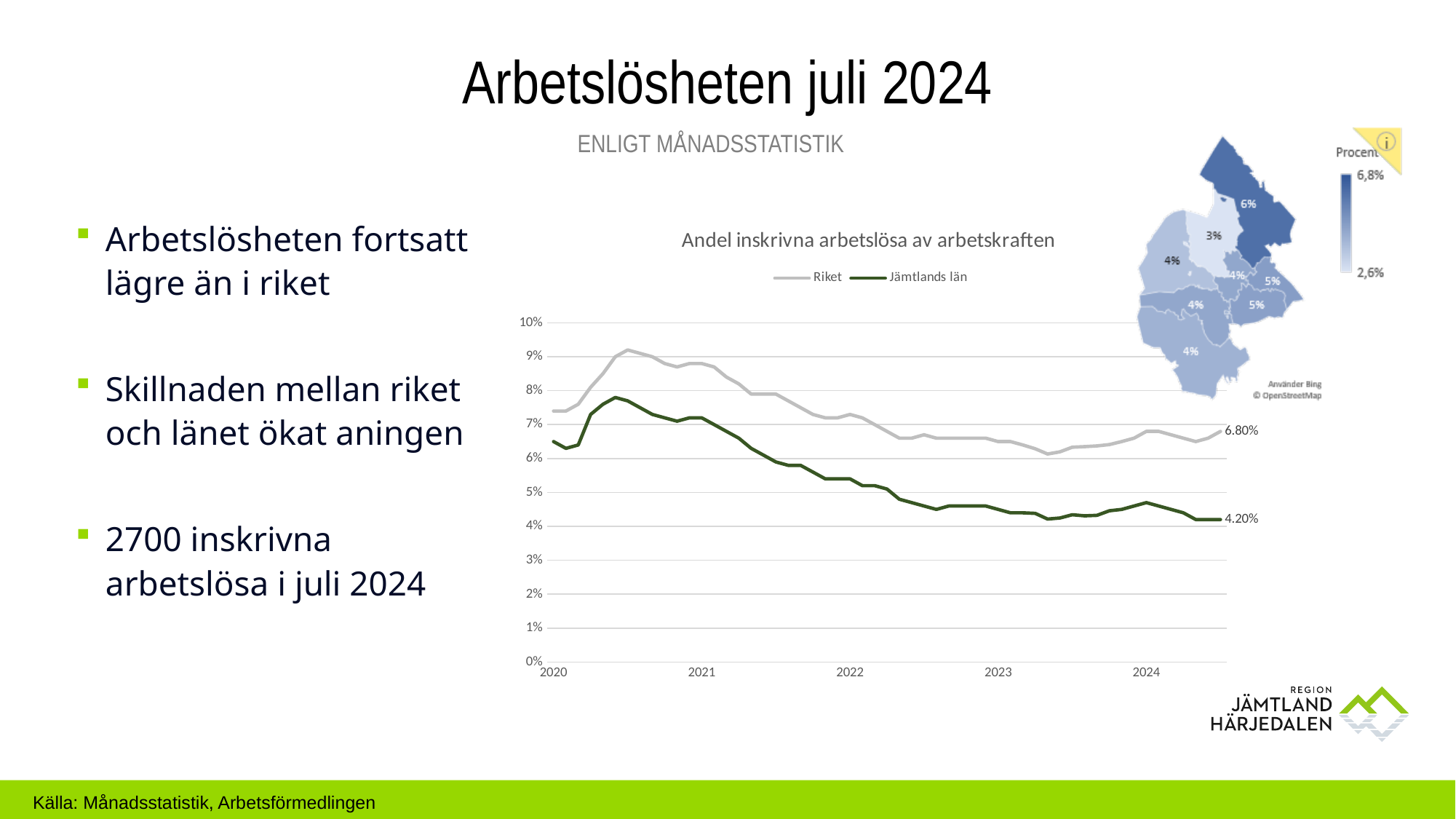
What is the latest value shown for Jämtlands län in the line chart? 4.20% Which series reaches the higher peak in the line chart? Riket What is the difference between the latest labelled values for Riket and Jämtlands län? 2.60% At the end of the line chart, which series has the higher value, Riket or Jämtlands län? Riket What is the title of the line chart? Andel inskrivna arbetslösa av arbetskraften What is the latest value shown for Riket in the line chart? 6.80% What kind of chart is used to show 'Andel inskrivna arbetslösa av arbetskraften'? Line chart Does the Jämtlands län line rise or fall overall from 2022 to 2024? Fall Is the value for Jämtlands län at the start of 2020 greater or less than 7%? less How many series does the legend of the line chart list? 2 Is the value for Riket at the start of 2020 greater or less than 7%? greater Is the value for Jämtlands län at the start of 2023 greater or less than 5%? less